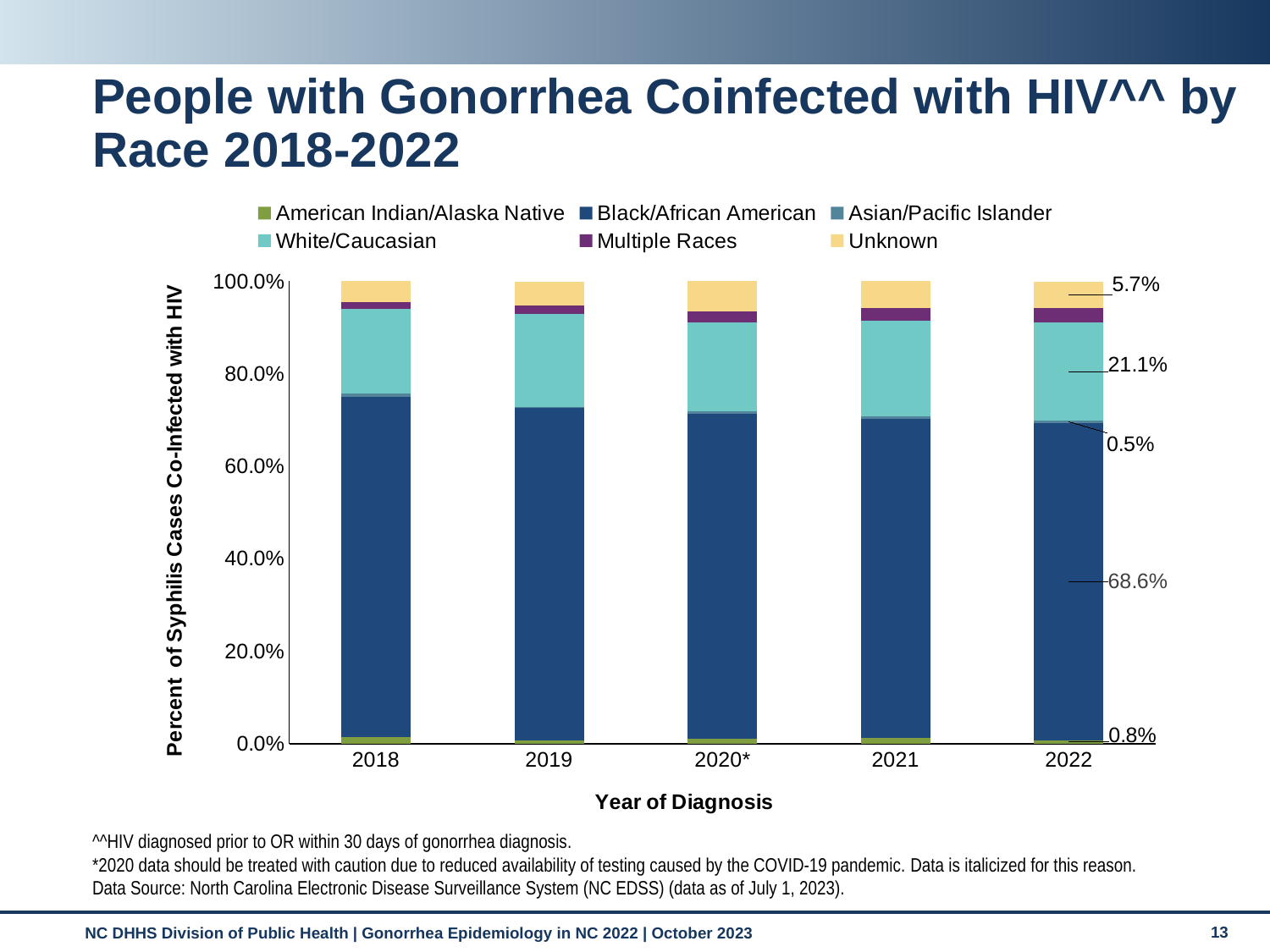
What is the American Indian/Alaska Native value labeled for 2022? 0.8% In 2022, how many percentage points larger is the Black/African American share than the White/Caucasian share? 47.5 percentage points How many race categories does the legend list? 6 Which race group makes up the largest share of the 2022 bar? Black/African American What is the White/Caucasian share shown for 2022? 21.1% How many years are shown on the x axis? 5 What is the Unknown share labeled for 2022? 5.7% What is the Asian/Pacific Islander value labeled for 2022? 0.5% Is the Black/African American share in 2018 greater or less than 60.0%? greater What kind of chart is shown on the slide? Stacked bar chart What percentage of the 2022 bar is Black/African American? 68.6% In 2022, which is larger: the White/Caucasian share or the Unknown share? White/Caucasian